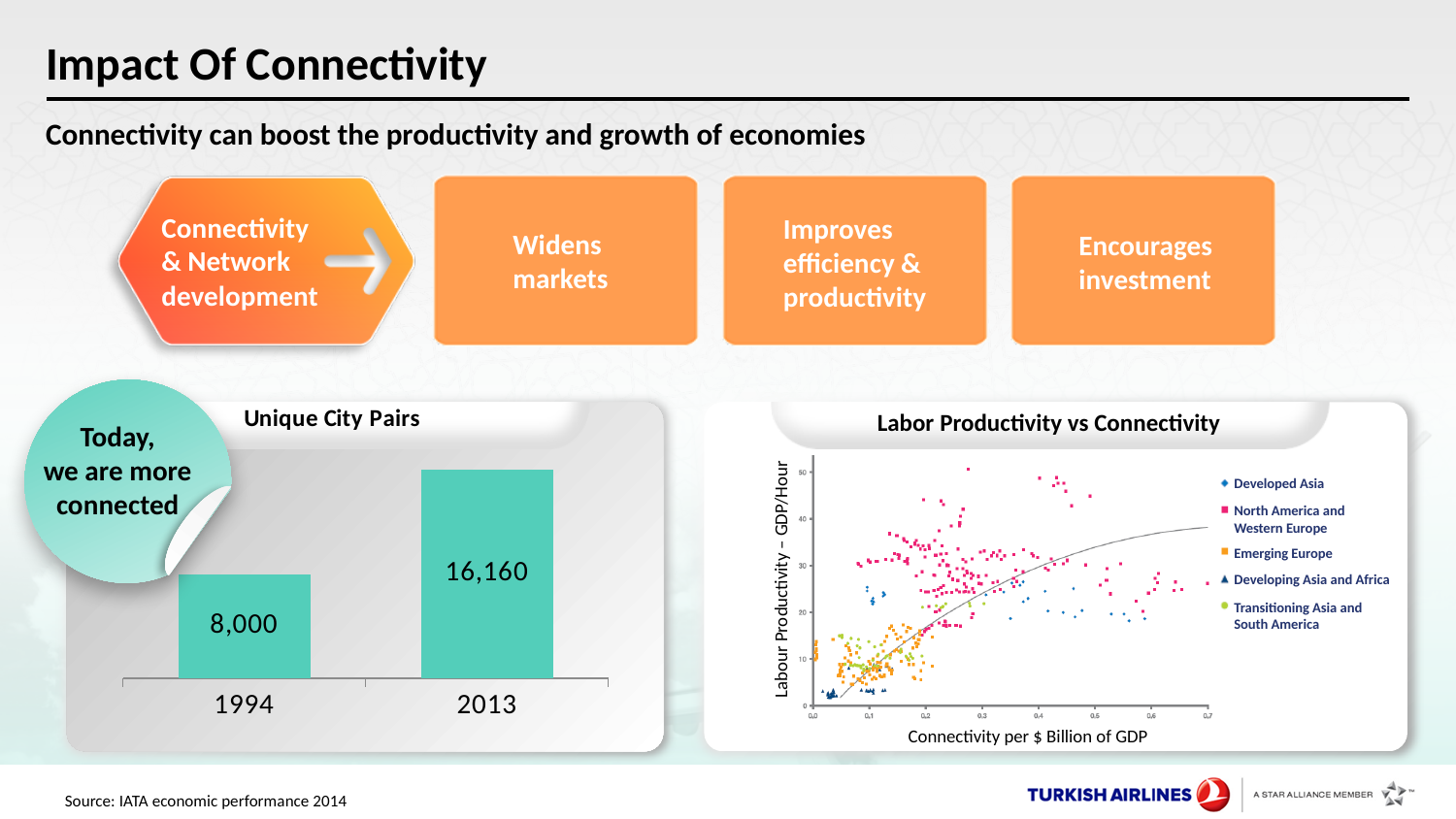
In the Labor Productivity vs Connectivity chart, how many series does the legend list? 5 In the Labor Productivity vs Connectivity chart, which legend entry is shown in red? North America and Western Europe In the Labor Productivity vs Connectivity chart, what is the label of the x axis? Connectivity per $ Billion of GDP In the Unique City Pairs chart, what is the difference between the 2013 and 1994 values? 8,160 In the Unique City Pairs chart, how many years are shown? 2 In the Unique City Pairs chart, what is the value for 1994? 8,000 What kind of chart is the Labor Productivity vs Connectivity chart? Scatter plot In the Unique City Pairs chart, which year has the lower value? 1994 In the Unique City Pairs chart, what is the value for 2013? 16,160 In the Unique City Pairs chart, do the values rise or fall from 1994 to 2013? Rise In the Unique City Pairs chart, which year has the higher value? 2013 What kind of chart is the Unique City Pairs chart? Bar chart